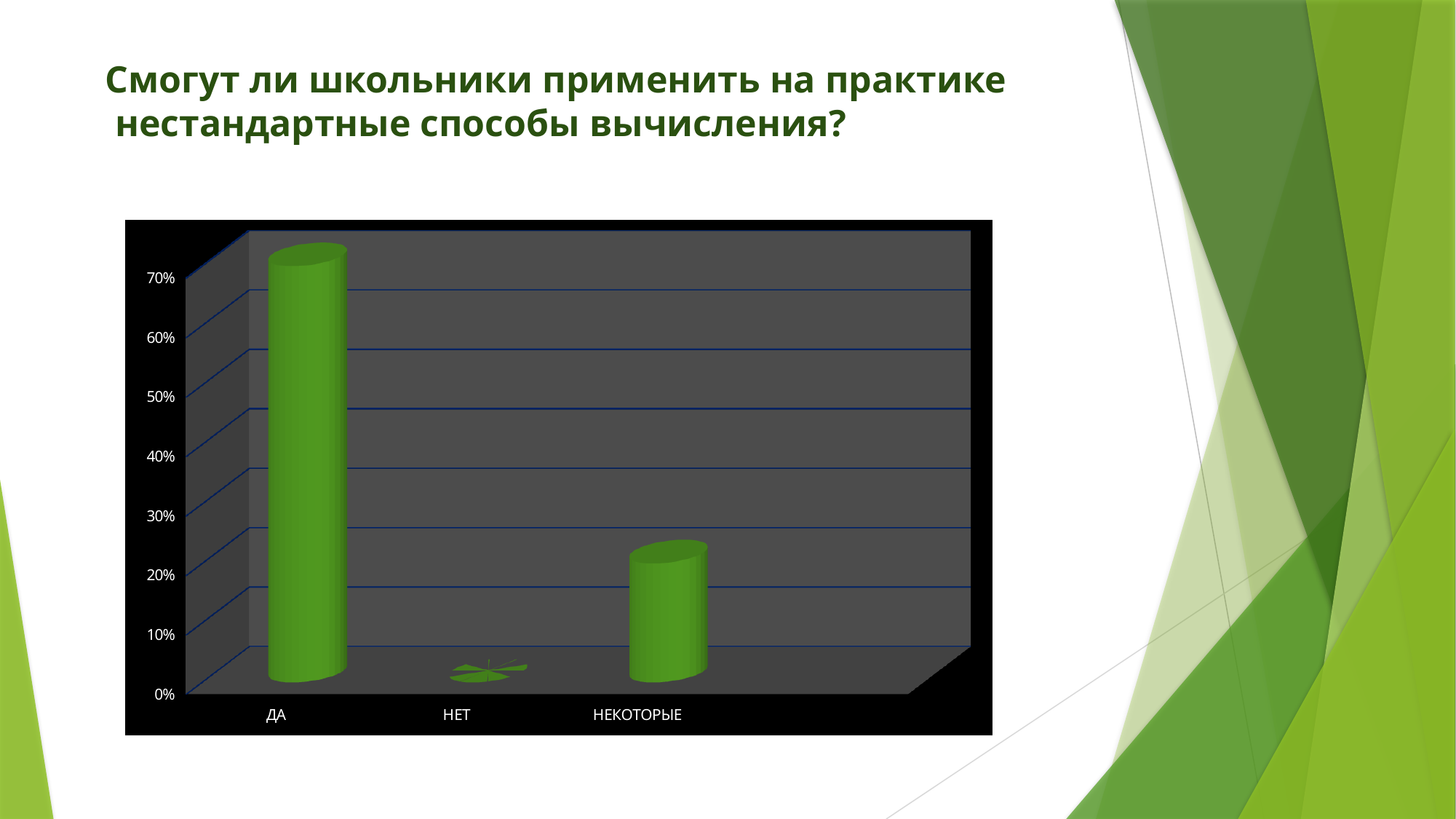
Which category has the lowest value in the chart? НЕТ Is the value for НЕКОТОРЫЕ greater or less than 30%? less Is the value for НЕКОТОРЫЕ greater or less than 10%? greater Which category has the highest value in the chart? ДА Is the value for ДА greater or less than 60%? greater What colour are the bars in the chart? green Which is larger, the value for НЕКОТОРЫЕ or the value for НЕТ? НЕКОТОРЫЕ Which is larger, the value for ДА or the value for НЕКОТОРЫЕ? ДА How many categories are shown on the x axis of the chart? 3 What is the highest percentage tick shown on the vertical axis of the chart? 70% What kind of chart is shown on the slide? bar chart